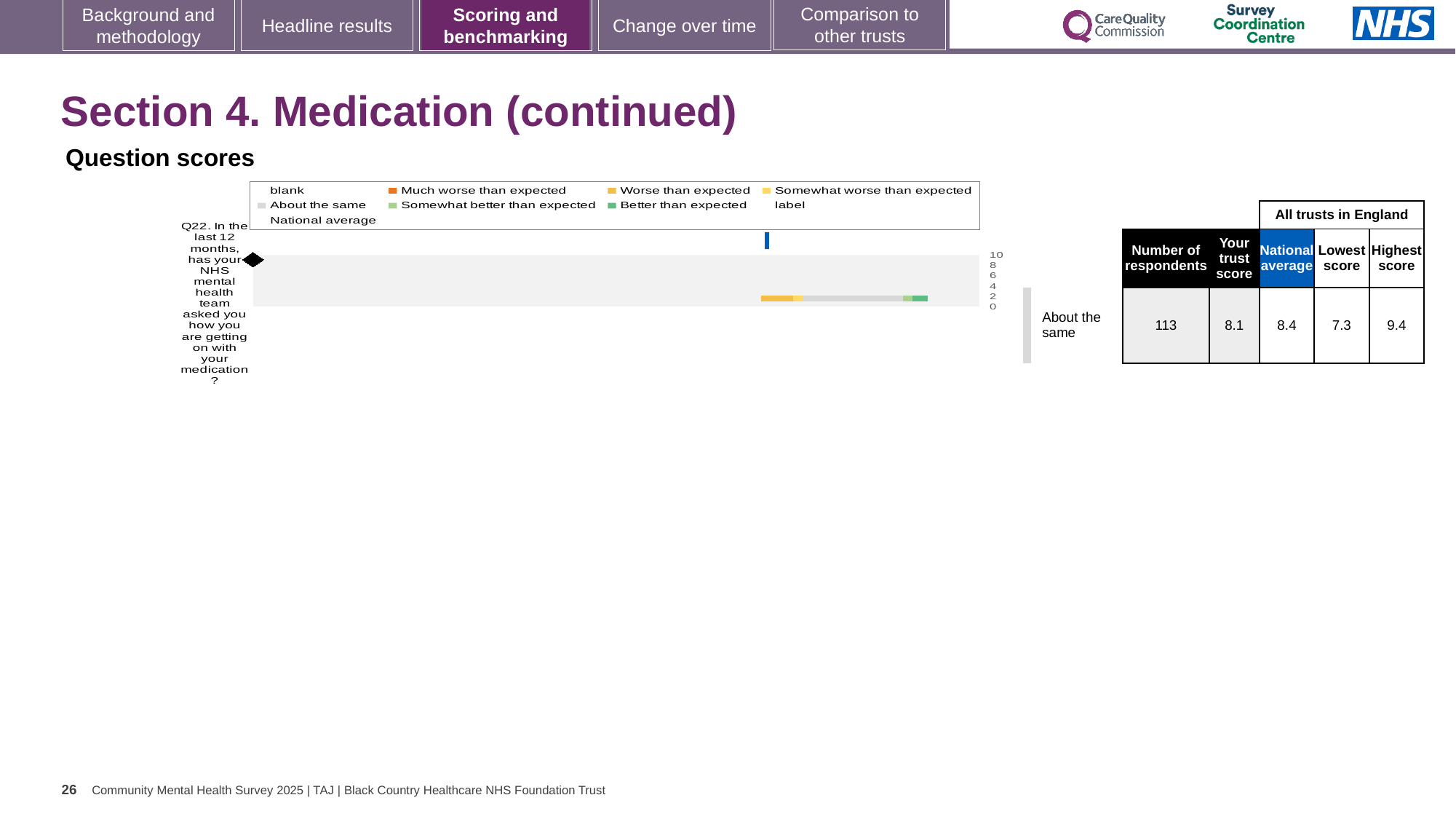
For Q22, which is larger: the trust score or the national average? National average What is the lowest score among all trusts in England for Q22? 7.3 What is the highest score among all trusts in England for Q22? 9.4 What is the difference between the national average and the trust score for Q22? 0.3 How many respondents answered Q22? 113 How many survey questions are plotted in the Question scores chart? 1 What kind of chart is shown under 'Question scores'? bar chart What is the difference between the highest score and the lowest score for Q22? 2.1 What benchmark category is shown for Q22 next to the chart? About the same Which question is plotted in the Question scores chart? Q22. In the last 12 months, has your NHS mental health team asked you how you are getting on with your medication? What is the national average for Q22 in the table beside the chart? 8.4 What is the trust score for Q22 in the table beside the chart? 8.1